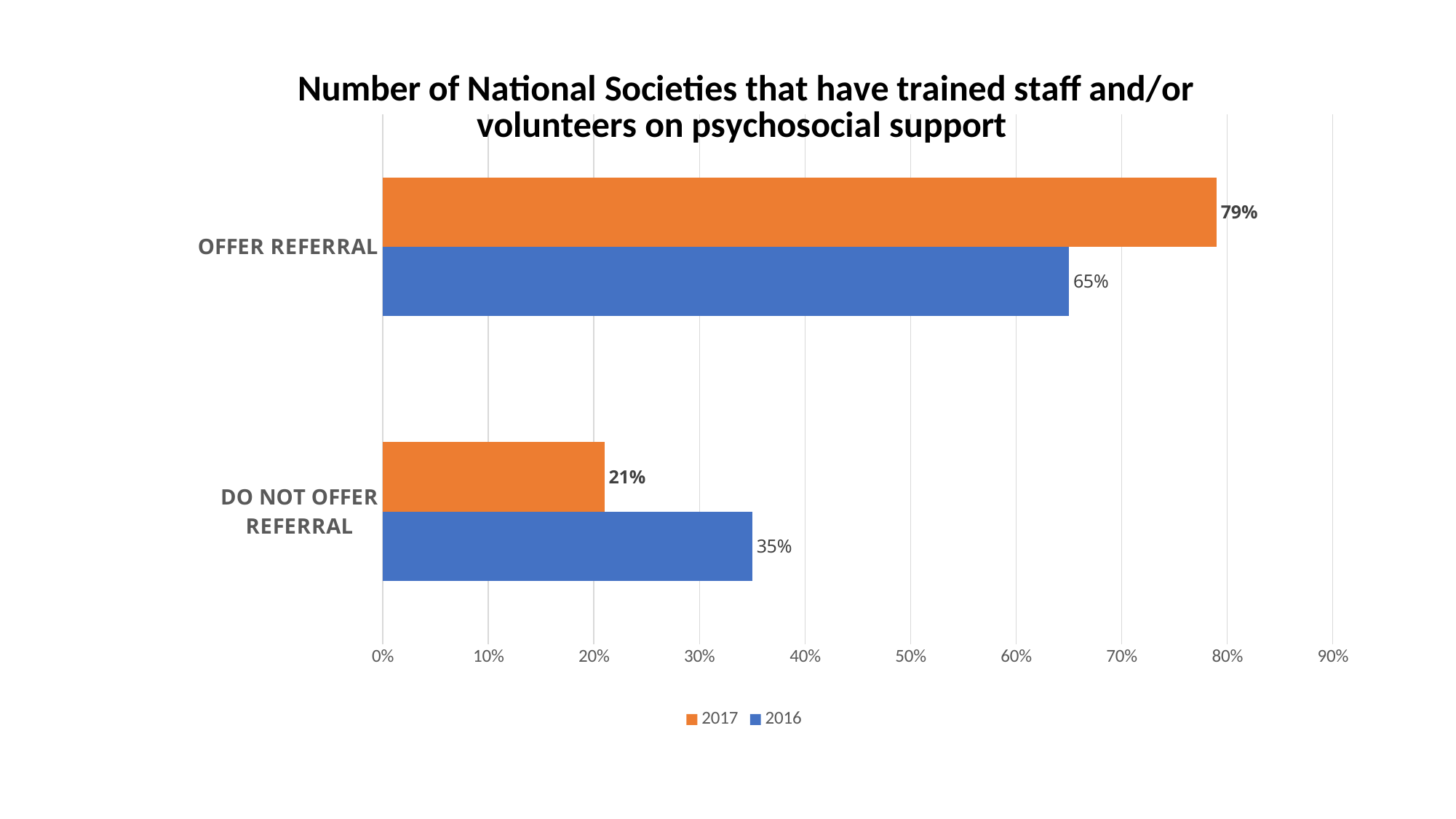
Which category has the highest 2017 value? Offer Referral Which category has the lowest 2016 value? Do Not Offer Referral For Do Not Offer Referral, which year has the larger value, 2016 or 2017? 2016 What is the 2016 value for Offer Referral? 65% What is the 2016 value for Do Not Offer Referral? 35% What is the 2017 value for Offer Referral? 79% Which colour represents the 2017 series? Orange What kind of chart is shown on the slide? Bar chart What is the 2017 value for Do Not Offer Referral? 21% What is the difference between the 2016 and 2017 values for Do Not Offer Referral? 14% How many series does the legend list? 2 What is the difference between the 2017 and 2016 values for Offer Referral? 14%